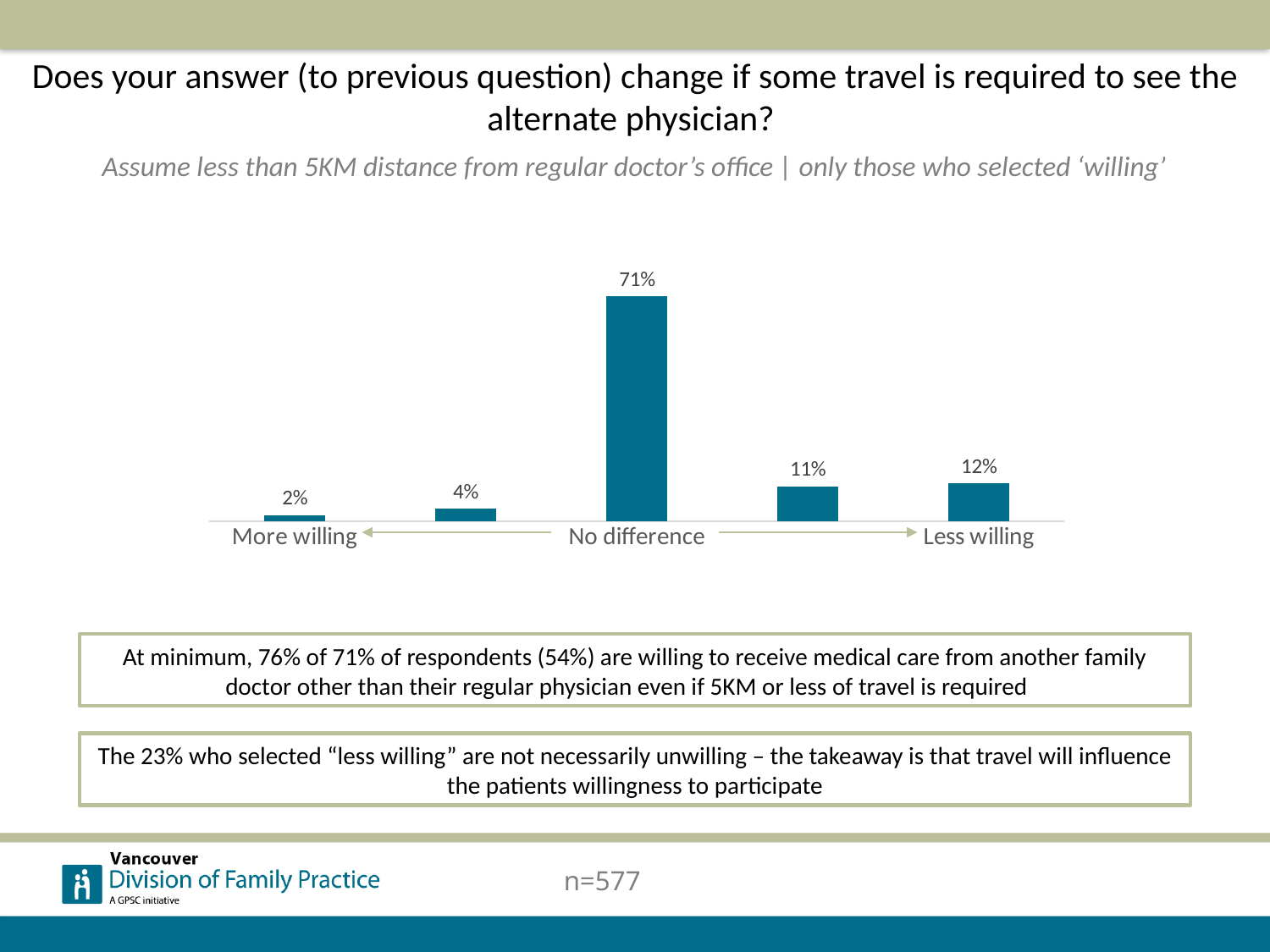
How many bars are plotted in the chart? 5 Which is larger, the value for 'More willing' or the value for 'Less willing'? Less willing What sample size (n) is shown at the bottom of the slide? n=577 What is the difference between the 'Less willing' value and the 'More willing' value? 10% What percentage of respondents selected 'Less willing'? 12% What percentage of respondents selected 'No difference'? 71% Which labelled category has the lowest value in the chart? More willing What is the difference between the 'No difference' value and the 'Less willing' value? 59% Which category has the highest value in the chart? No difference What percentage of respondents selected 'More willing'? 2% What is the value of the bar immediately to the right of 'No difference'? 11% What kind of chart is shown on the slide? Bar chart